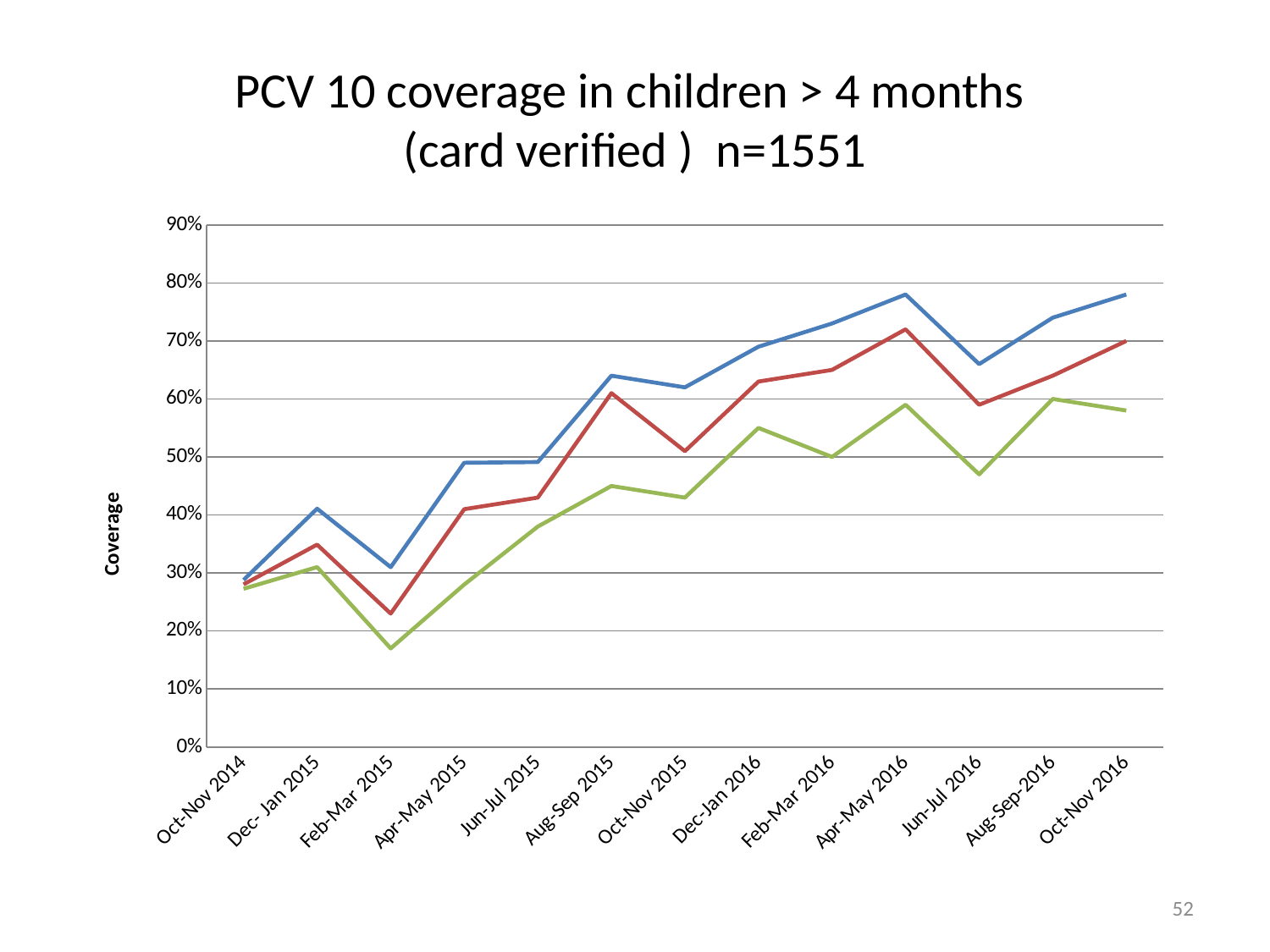
What kind of chart is shown on the slide? line chart Is the value of the green line for Oct-Nov 2016 greater or less than 60%? less Overall, do the lines rise or fall from Oct-Nov 2014 to Oct-Nov 2016? rise In which period does the green line reach its lowest value? Feb-Mar 2015 What is the label on the vertical axis? Coverage How many time periods are shown along the x axis? 13 Is the value of the blue line for Apr-May 2016 greater or less than 70%? greater How many lines are plotted on the chart? 3 In which period does the red line reach its lowest value? Feb-Mar 2015 Is the value of the blue line for Jun-Jul 2016 greater or less than 60%? greater For Oct-Nov 2016, which line has the higher value, the blue line or the green line? blue line